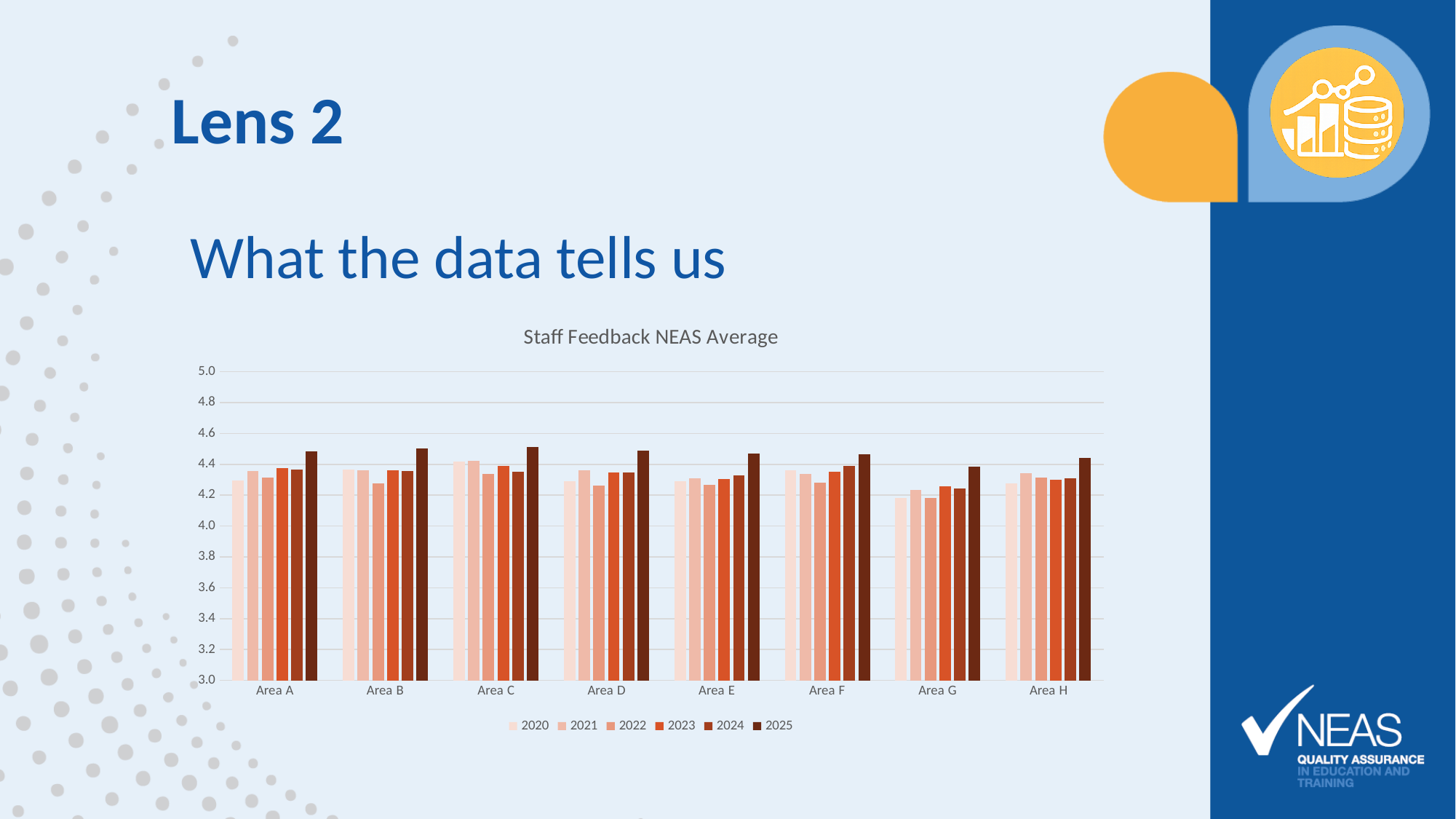
Is the value for 2022 in Area G greater or less than 4.0? greater Which is larger: the 2025 bar for Area C or the 2025 bar for Area G? Area C In Area A, which year has the highest bar? 2025 Which area has the lowest 2020 bar? Area G Which area has the highest 2020 bar? Area C How many areas (categories) are shown on the x axis of the chart? 8 Is the value for 2025 in Area C greater or less than 4.4? greater How many series does the chart legend list? 6 Is the value for 2020 in Area A greater or less than 4.4? less What is the title of the chart? Staff Feedback NEAS Average Which years are listed in the chart legend? 2020, 2021, 2022, 2023, 2024, 2025 What type of chart is shown on the slide? Bar chart